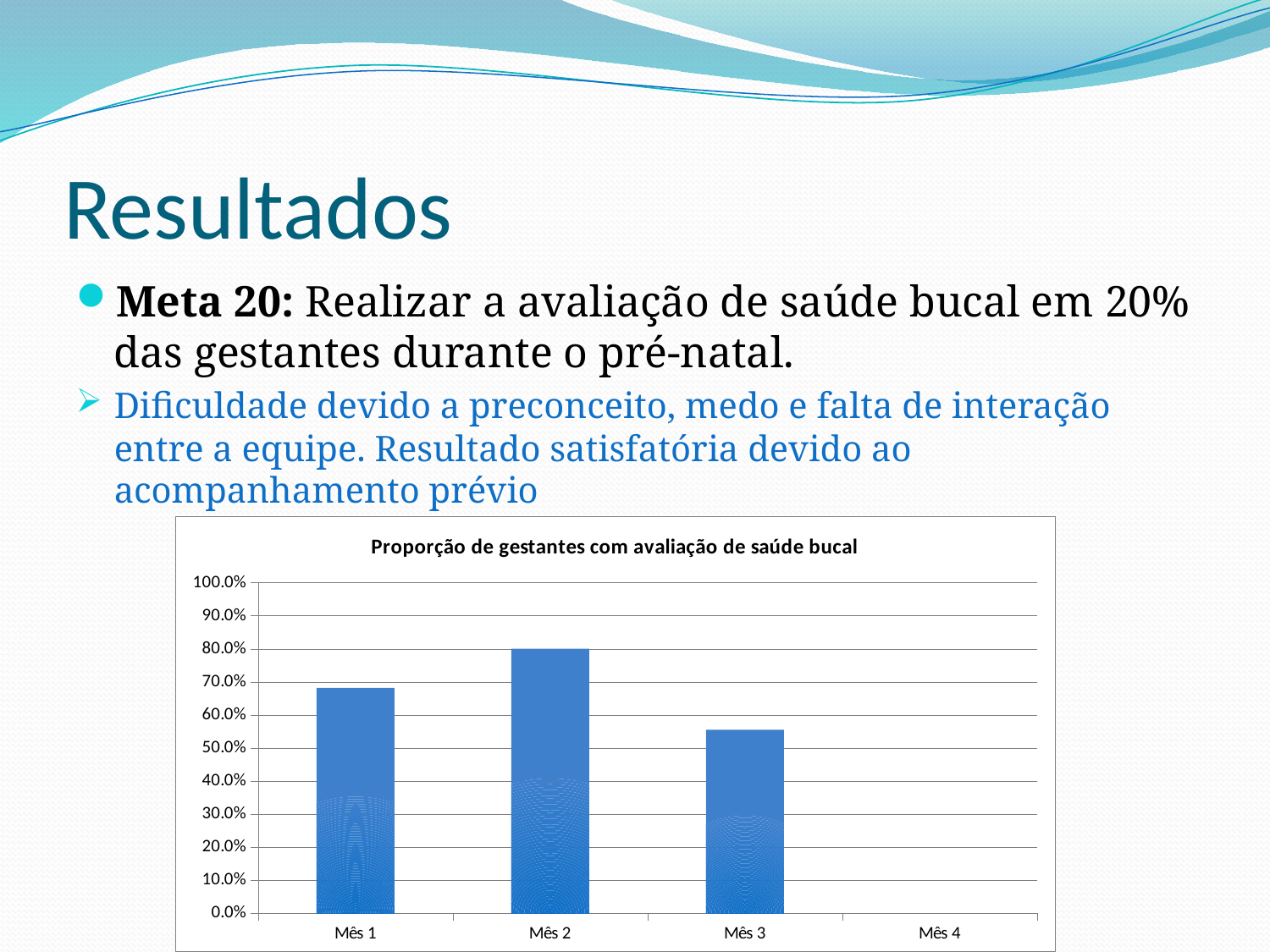
Is the value for Mês 1 greater or less than 60.0%? greater What is the value for Mês 2 in the chart? 80.0% What is the highest value shown on the y axis of the chart? 100.0% Which month has the highest proportion in the chart? Mês 2 Does the value rise or fall from Mês 2 to Mês 3? fall Is the value for Mês 3 greater or less than 50.0%? greater Which month has the lowest proportion in the chart? Mês 4 Is the value for Mês 1 greater or less than 70.0%? less Which is larger, the value for Mês 1 or the value for Mês 3? Mês 1 What is the title of the chart? Proporção de gestantes com avaliação de saúde bucal What kind of chart is shown on the slide? bar chart How many categories are shown on the x axis of the chart? 4